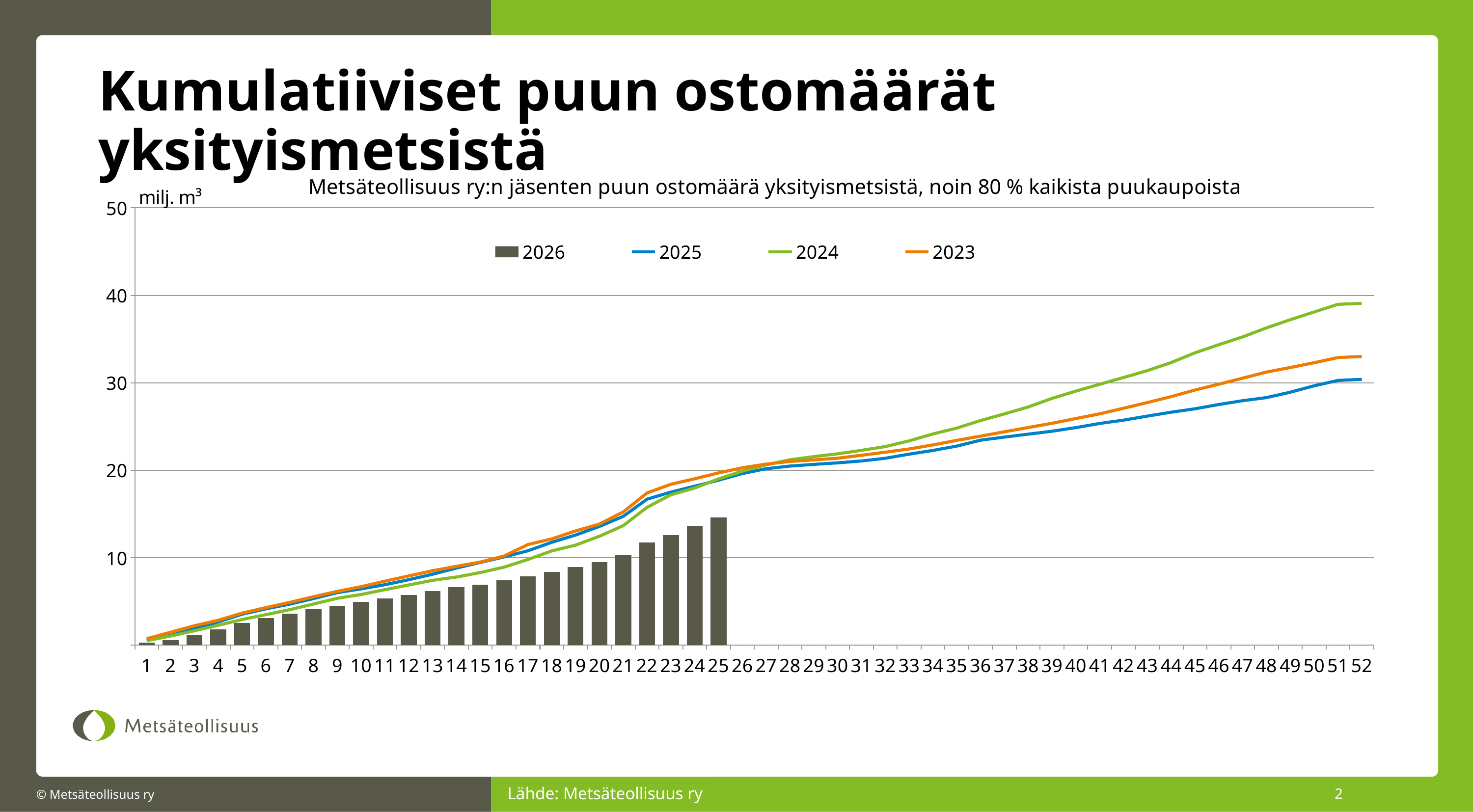
At week 25, which is larger: the 2026 bar or the 2025 line? 2025 What unit is shown on the y axis? milj. m³ For how many weeks are bars plotted for the 2026 series? 25 Is the value for 2026 at week 25 greater or less than 20? less Is the value for 2024 at week 52 greater or less than 40? less Which series has the highest value at week 52? 2024 Which series has the lowest value at week 52? 2025 How many week categories are shown on the x axis? 52 Is the value for 2023 at week 52 greater or less than 30? greater What kind of chart is shown on the slide? A combined bar and line chart How many series does the legend list? 4 Do the values of the 2025 line rise or fall along the x axis? Rise